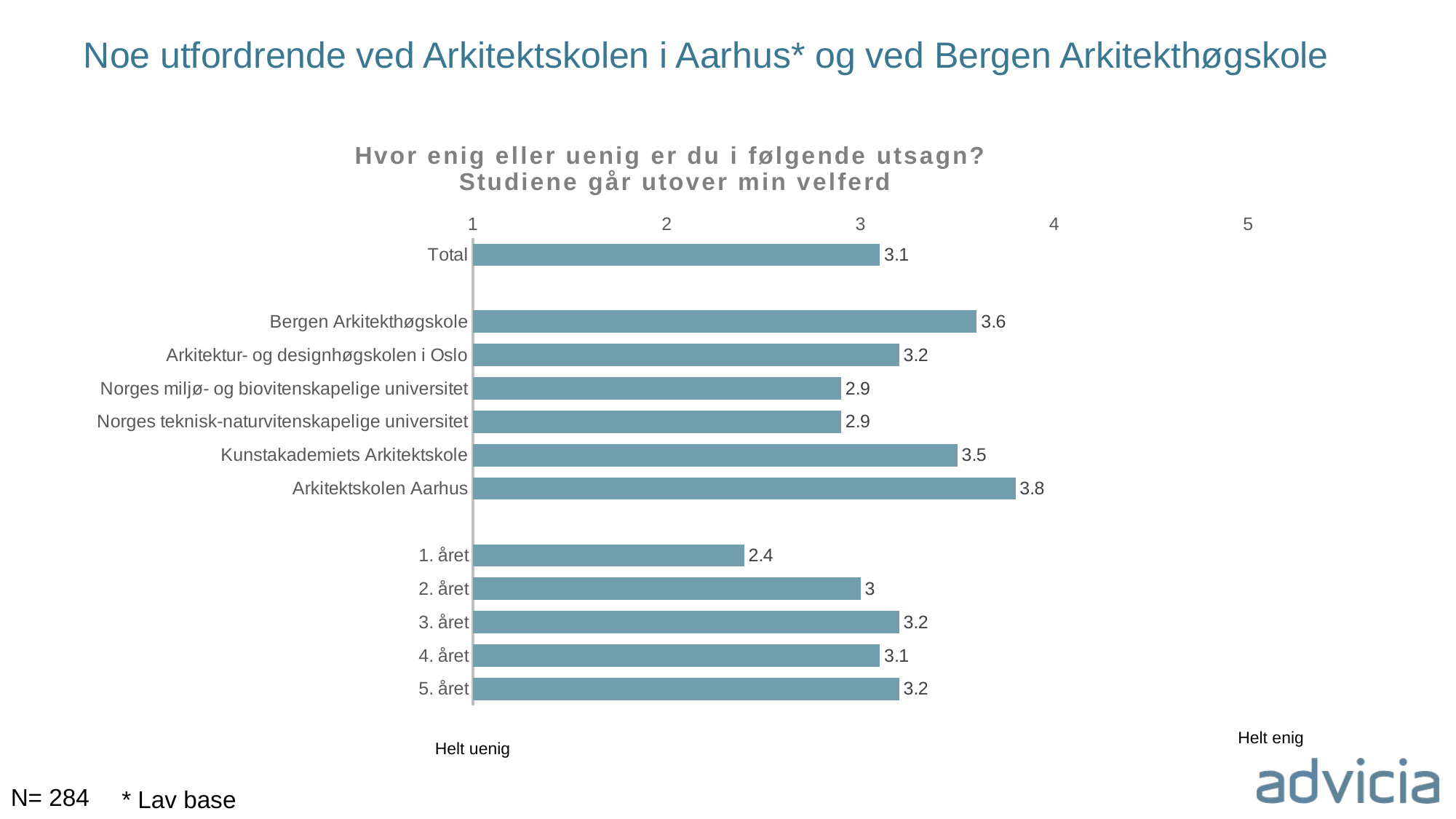
Is the value for 1. året greater or less than 3? less Which is larger, the value for Kunstakademiets Arkitektskole or the value for Arkitektur- og designhøgskolen i Oslo? Kunstakademiets Arkitektskole Which category has the lowest value? 1. året What kind of chart is shown on the slide? Bar chart What is the statement shown in the chart title that respondents rated? Studiene går utover min velferd What is the value for Bergen Arkitekthøgskole? 3.6 How many bars are plotted in the chart? 12 What is the value for Arkitektskolen Aarhus? 3.8 Which category has the highest value? Arkitektskolen Aarhus What is the value for Total? 3.1 What is the value for 1. året? 2.4 What is the difference between the values for Arkitektskolen Aarhus and Bergen Arkitekthøgskole? 0.2